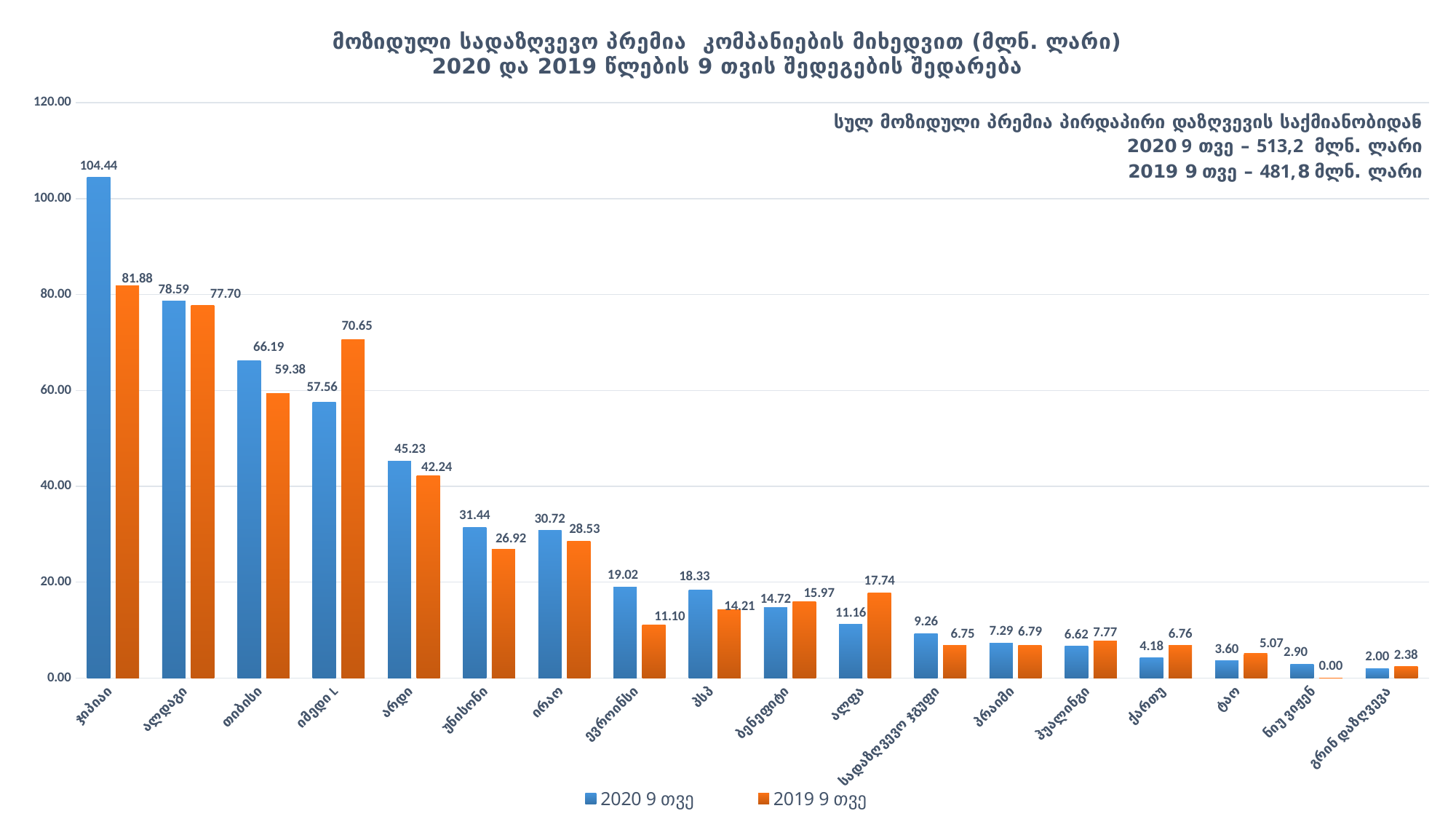
How many companies are shown on the x axis? 18 Which company has the highest value in the 2020 9 თვე series? ჯიპიაი What is the value for ჯიპიაი in the 2020 9 თვე series? 104.44 What is the value for ნიუ ვიჟენ in the 2019 9 თვე series? 0.00 Is the 2020 9 თვე value for თიბისი greater or less than 60.00? greater For იმედი L, which series has the larger value: 2020 9 თვე or 2019 9 თვე? 2019 9 თვე What is the value for იმედი L in the 2019 9 თვე series? 70.65 What is the difference between the 2020 9 თვე and 2019 9 თვე values for ჯიპიაი? 22.56 What kind of chart is shown on the slide? bar chart Which colour represents the 2019 9 თვე series? orange How many series does the legend list? 2 Which company has the lowest value in the 2020 9 თვე series? გრინ დაზღვევა